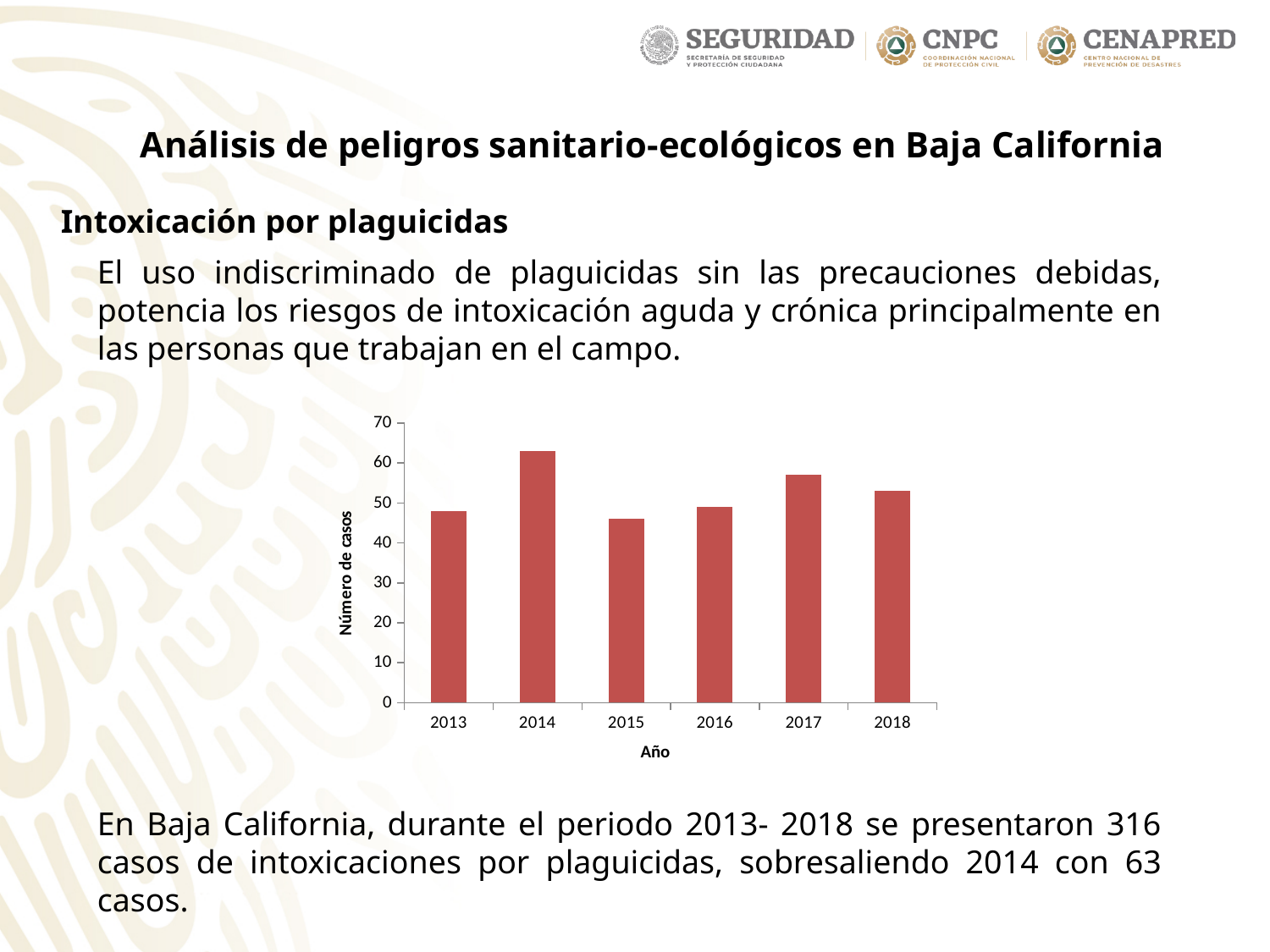
Is the value for 2015 greater or less than 50? less Which year has the larger value, 2017 or 2015? 2017 Is the value for 2018 greater or less than 60? less What kind of chart is shown on the slide? bar chart According to the slide, how many cases were recorded in 2014? 63 How many years are shown on the x axis of the chart? 6 Do the values rise or fall from 2015 to 2017? rise Is the value for 2014 greater or less than 60? greater What is the title of the vertical axis of the chart? Número de casos What is the title of the horizontal axis of the chart? Año Which year has the highest number of cases in the chart? 2014